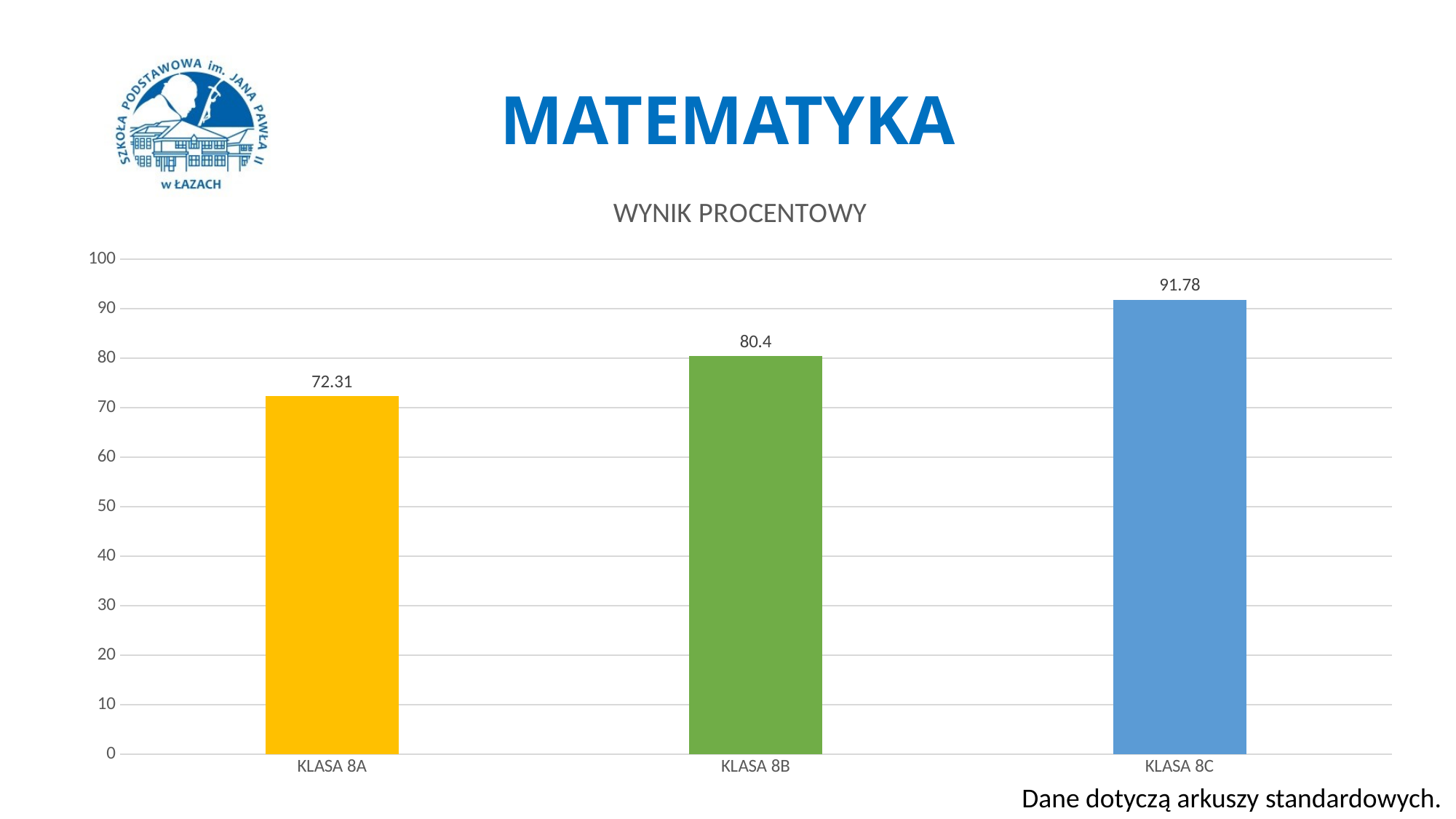
What is the value for KLASA 8B? 80.4 Which class has the lowest value? KLASA 8A Is the value for KLASA 8B greater or less than 90? less What is the title of the chart? WYNIK PROCENTOWY Which is larger, the value for KLASA 8B or KLASA 8C? KLASA 8C How many classes are shown in the chart? 3 What is the value for KLASA 8C? 91.78 What is the value for KLASA 8A? 72.31 What kind of chart is shown on the slide? bar chart Which class has the highest value? KLASA 8C What is the difference between the values for KLASA 8B and KLASA 8A? 8.09 What is the difference between the values for KLASA 8C and KLASA 8A? 19.47